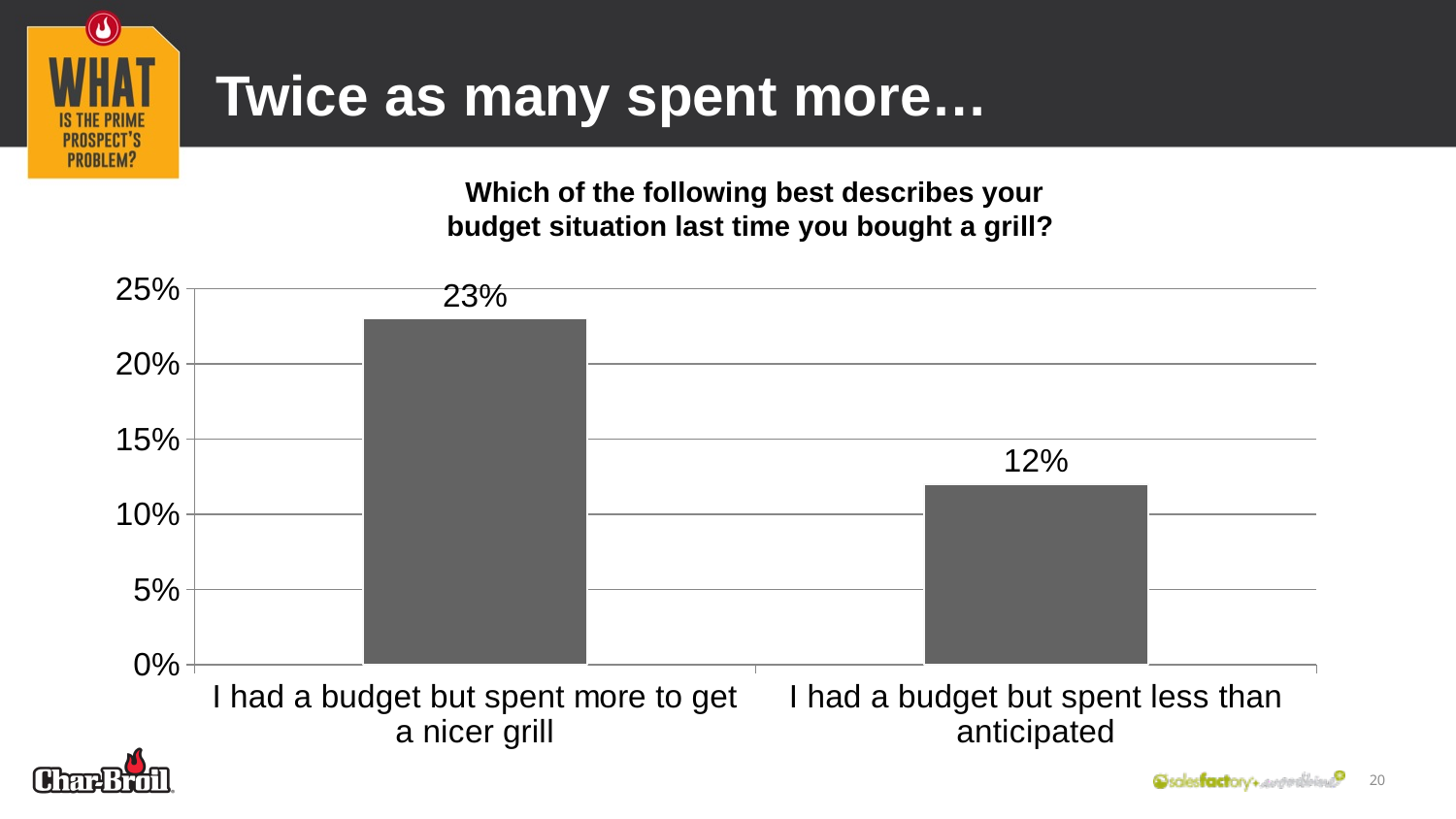
Is the value for 'I had a budget but spent more to get a nicer grill' greater or less than 20%? greater What percentage of respondents said they had a budget but spent less than anticipated? 12% Is the value for 'I had a budget but spent less than anticipated' greater or less than 15%? less What type of chart is shown on the slide? bar chart Which response has the lower percentage? I had a budget but spent less than anticipated How many response categories are shown in the chart? 2 What percentage of respondents said they had a budget but spent more to get a nicer grill? 23% Which response has the higher percentage? I had a budget but spent more to get a nicer grill What is the difference in percentage points between the two responses? 11% What survey question is the chart based on? Which of the following best describes your budget situation last time you bought a grill? Is the value for 'I had a budget but spent more to get a nicer grill' larger or smaller than the value for 'I had a budget but spent less than anticipated'? larger What is the maximum value shown on the vertical axis? 25%